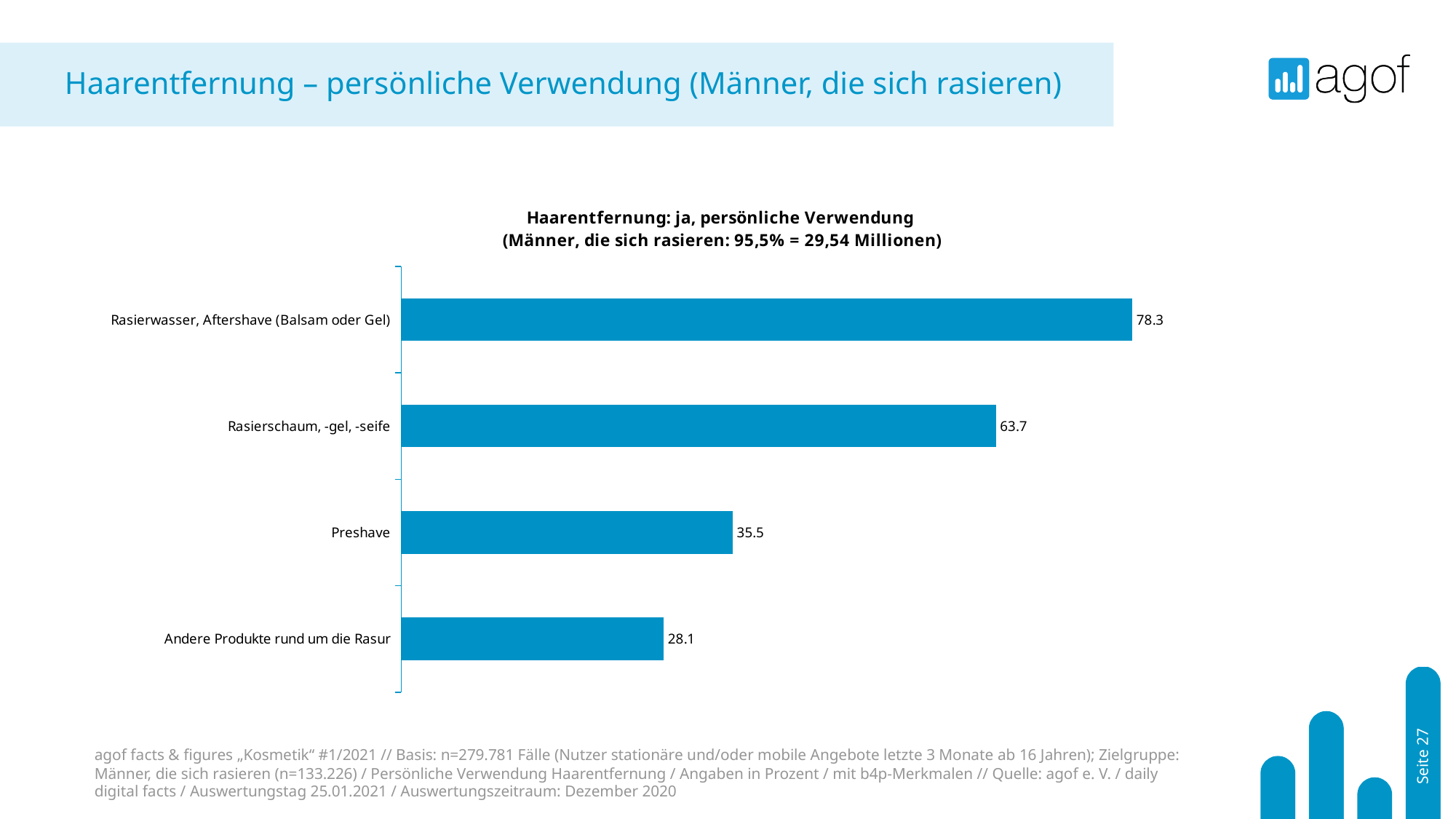
What is the difference between the values for Rasierwasser, Aftershave (Balsam oder Gel) and Rasierschaum, -gel, -seife? 14.6 What is the value for Preshave? 35.5 Which is larger, the value for Preshave or the value for Andere Produkte rund um die Rasur? Preshave What is the title of the chart? Haarentfernung: ja, persönliche Verwendung (Männer, die sich rasieren: 95,5% = 29,54 Millionen) How many categories are shown in the chart? 4 Which category has the lowest value? Andere Produkte rund um die Rasur What is the value for Andere Produkte rund um die Rasur? 28.1 What is the value for Rasierwasser, Aftershave (Balsam oder Gel)? 78.3 What kind of chart is shown on the slide? Bar chart Which category has the highest value? Rasierwasser, Aftershave (Balsam oder Gel) What is the difference between the values for Preshave and Andere Produkte rund um die Rasur? 7.4 What is the value for Rasierschaum, -gel, -seife? 63.7